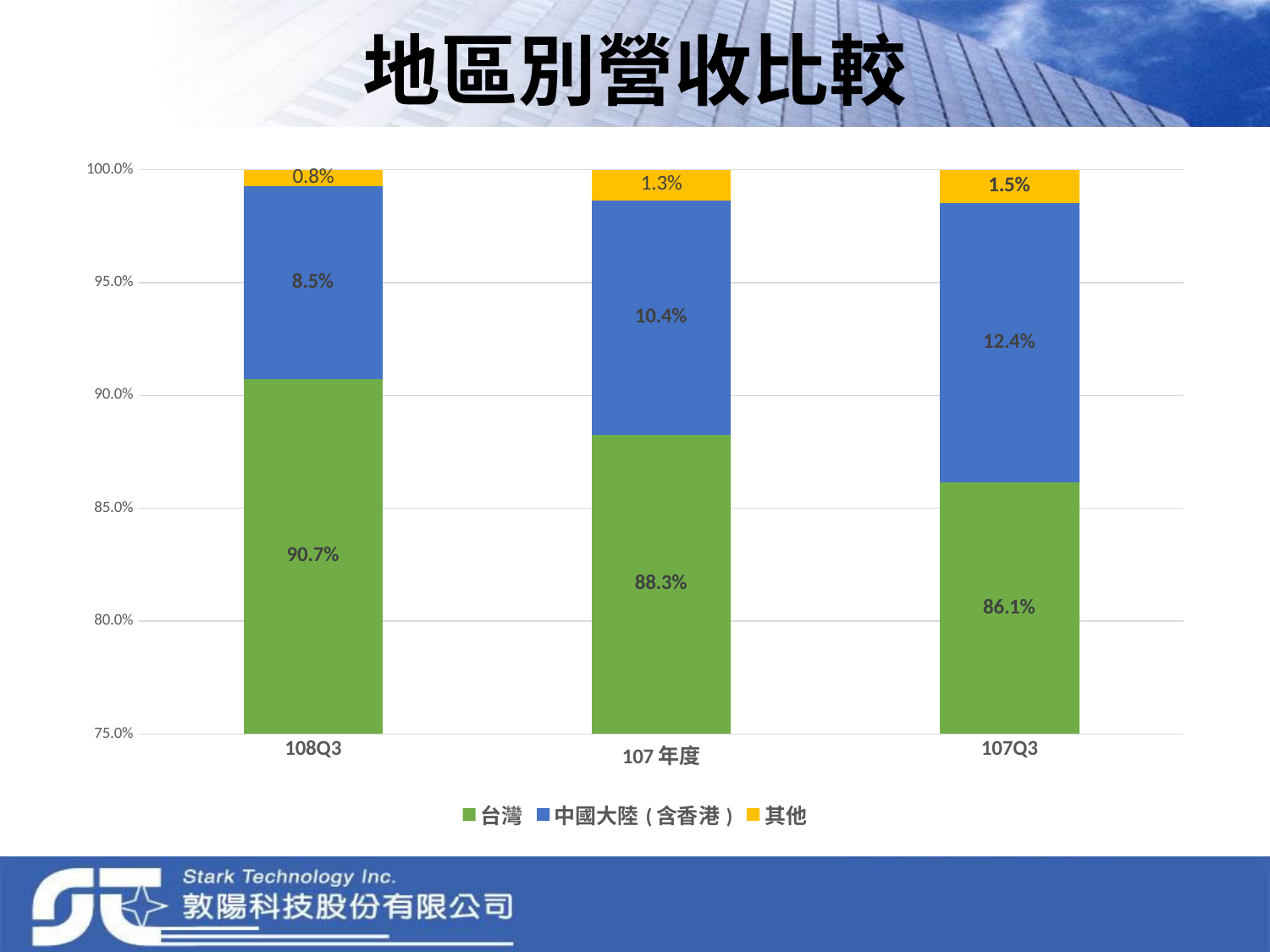
What is the value for 台灣 in 108Q3? 90.7% Which period has the lowest value for 其他? 108Q3 Which is larger, the 中國大陸（含香港） value for 107 年度 or for 107Q3? 107Q3 Which period has the highest value for 台灣? 108Q3 What is the title of the chart? 地區別營收比較 What is the value for 中國大陸（含香港） in 107 年度? 10.4% What kind of chart is shown? stacked bar chart What is the difference between the 台灣 values for 108Q3 and 107Q3? 4.6% What is the value for 其他 in 107Q3? 1.5% How many periods are shown on the x axis? 3 Is the 台灣 value for 107Q3 greater or less than 85.0%? greater How many series does the legend list? 3